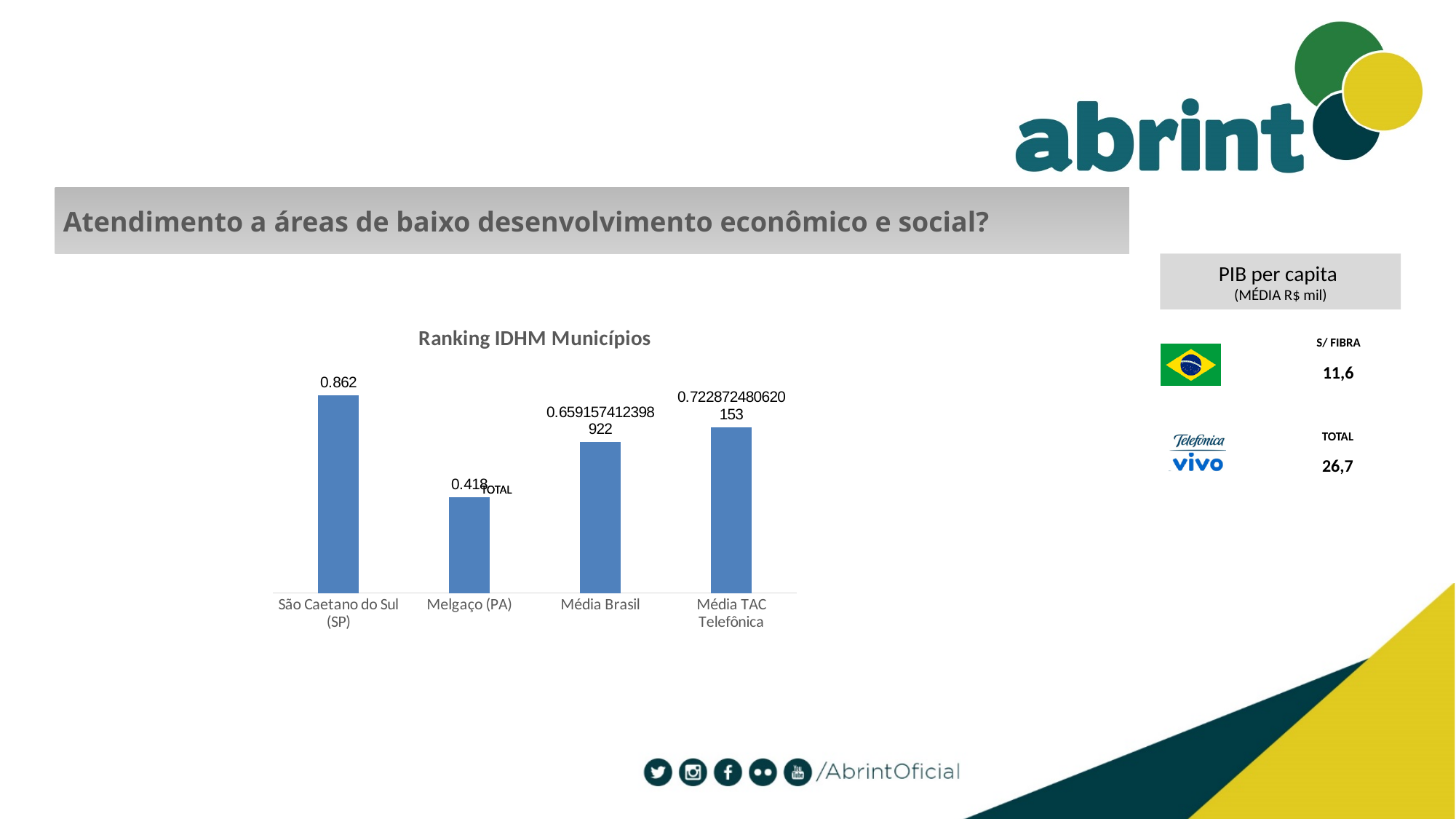
What kind of chart is the Ranking IDHM Municípios chart? Bar chart What is the value for São Caetano do Sul (SP) in the Ranking IDHM Municípios chart? 0.862 Which category has the highest value in the Ranking IDHM Municípios chart? São Caetano do Sul (SP) How many categories are shown in the Ranking IDHM Municípios chart? 4 In the Ranking IDHM Municípios chart, which is larger: Média Brasil or Média TAC Telefônica? Média TAC Telefônica What is the value for Melgaço (PA) in the Ranking IDHM Municípios chart? 0.418 In the Ranking IDHM Municípios chart, which is larger: Melgaço (PA) or Média Brasil? Média Brasil What is the value shown for Média Brasil in the Ranking IDHM Municípios chart? 0.659157412398922 What is the title of the chart on the slide? Ranking IDHM Municípios Which category has the lowest value in the Ranking IDHM Municípios chart? Melgaço (PA) What is the value shown for Média TAC Telefônica in the Ranking IDHM Municípios chart? 0.722872480620153 What is the difference between the values for São Caetano do Sul (SP) and Melgaço (PA) in the Ranking IDHM Municípios chart? 0.444